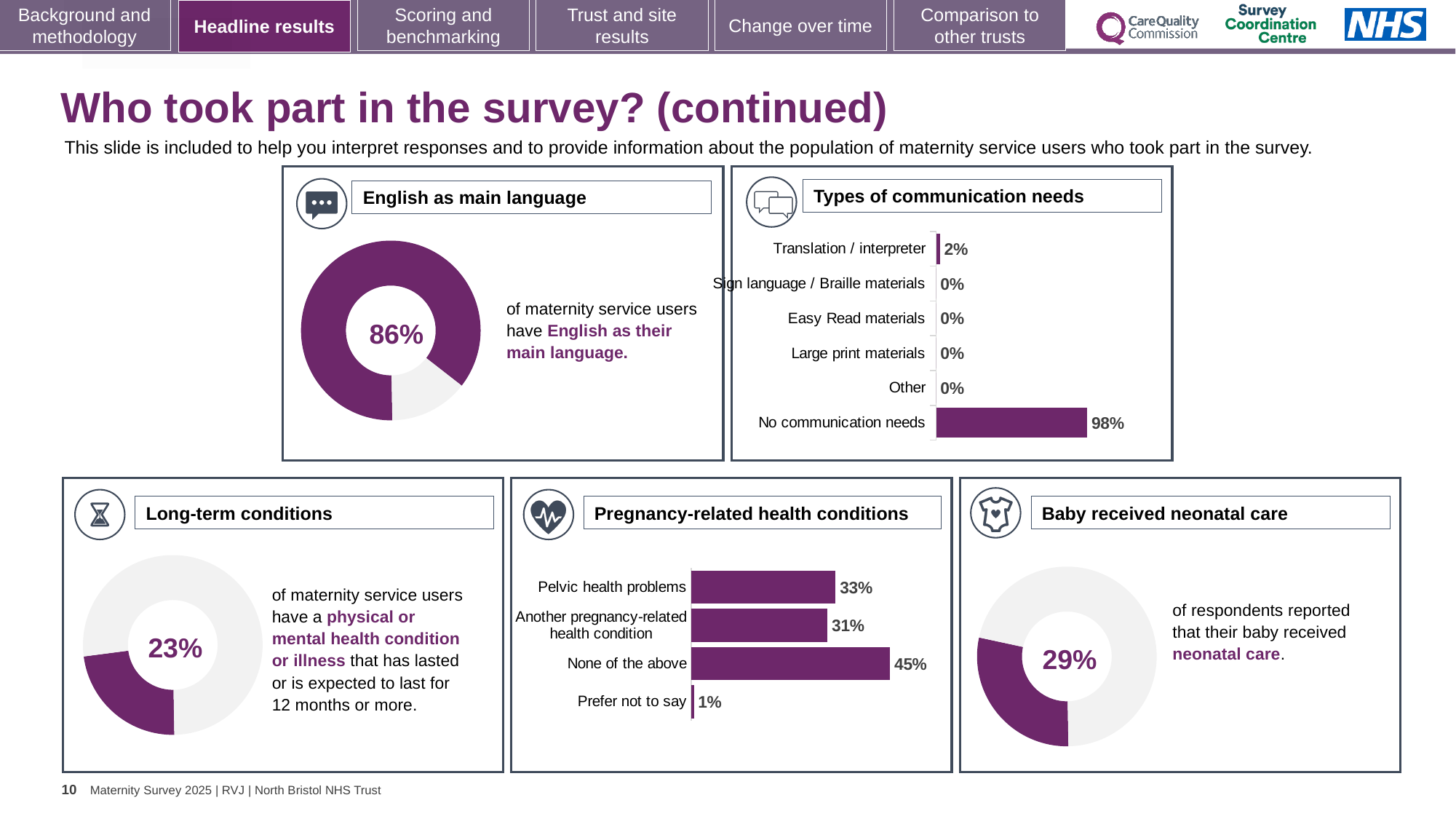
In the 'English as main language' chart, what percentage of maternity service users have English as their main language? 86% What kind of chart is the 'Types of communication needs' chart? Bar chart In the 'Types of communication needs' chart, which category has the highest value? No communication needs In the 'Pregnancy-related health conditions' chart, which is larger: 'Pelvic health problems' or 'Prefer not to say'? Pelvic health problems In the 'Pregnancy-related health conditions' chart, what is the value for 'Pelvic health problems'? 33% In the 'Pregnancy-related health conditions' chart, what is the difference between 'None of the above' and 'Another pregnancy-related health condition'? 14% In the 'Long-term conditions' chart, what percentage of maternity service users have a physical or mental health condition or illness? 23% In the 'Pregnancy-related health conditions' chart, which category has the highest value? None of the above In the 'Types of communication needs' chart, what is the value for 'Translation / interpreter'? 2% In the 'Types of communication needs' chart, what is the value for 'No communication needs'? 98% How many categories are shown in the 'Types of communication needs' chart? 6 In the 'Baby received neonatal care' chart, what percentage of respondents reported that their baby received neonatal care? 29%